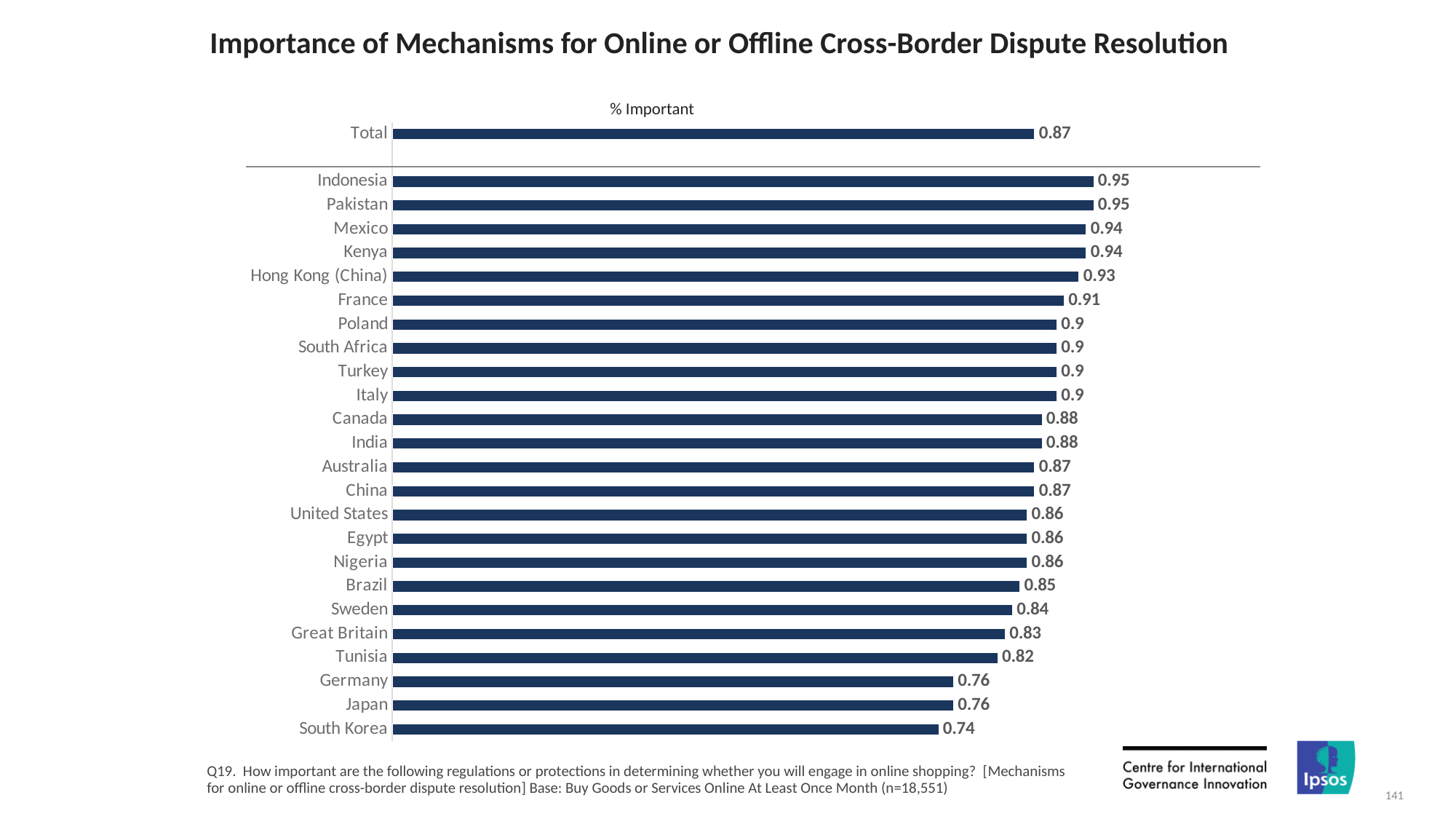
Which has a larger value, Mexico or Canada? Mexico What kind of chart is shown on the slide? Bar chart What is the value for Great Britain? 0.83 What is the value for Hong Kong (China)? 0.93 Which has a larger value, Sweden or Brazil? Brazil How many countries (excluding Total) are shown in the chart? 24 What is the difference between the values for France and Germany? 0.15 What is the label shown above the chart's bars? % Important What is the value for Total? 0.87 What is the difference between the values for Indonesia and South Korea? 0.21 What is the value for Tunisia? 0.82 Which country has the lowest value? South Korea